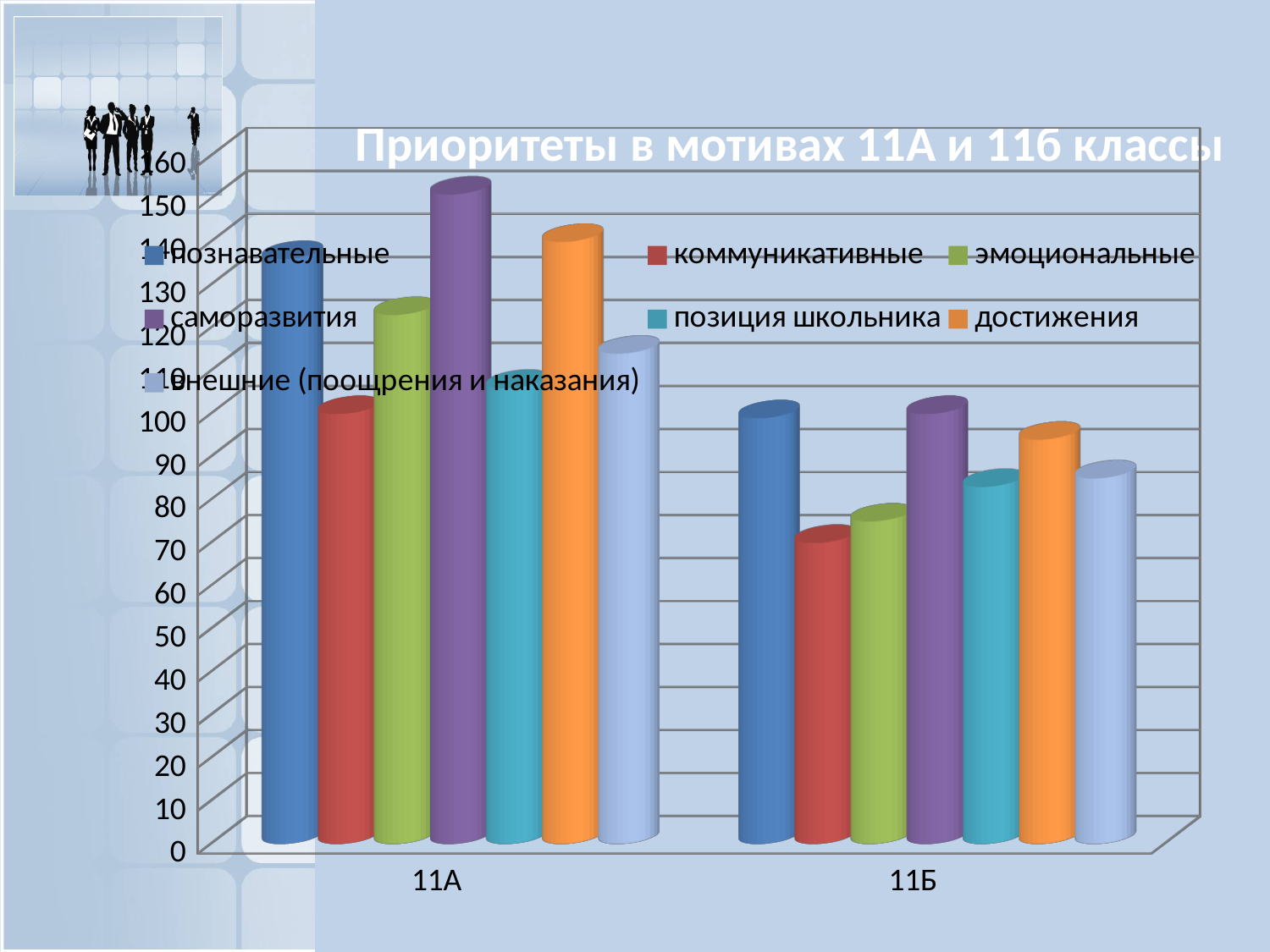
Which series has the lowest value for class 11А? коммуникативные Which series has the highest value for class 11А? саморазвития What is the title of the chart? Приоритеты в мотивах 11А и 11б классы What kind of chart is shown on the slide? bar chart How many series does the legend list? 7 Is the value for эмоциональные in class 11А greater or less than 110? greater Which colour represents the series достижения in the legend? orange Is the value for коммуникативные in class 11Б greater or less than 80? less Which series has the lowest value for class 11Б? коммуникативные Is the value for саморазвития in class 11А greater or less than 140? greater Which class has the larger value for саморазвития, 11А or 11Б? 11А How many categories (classes) are shown on the x axis? 2